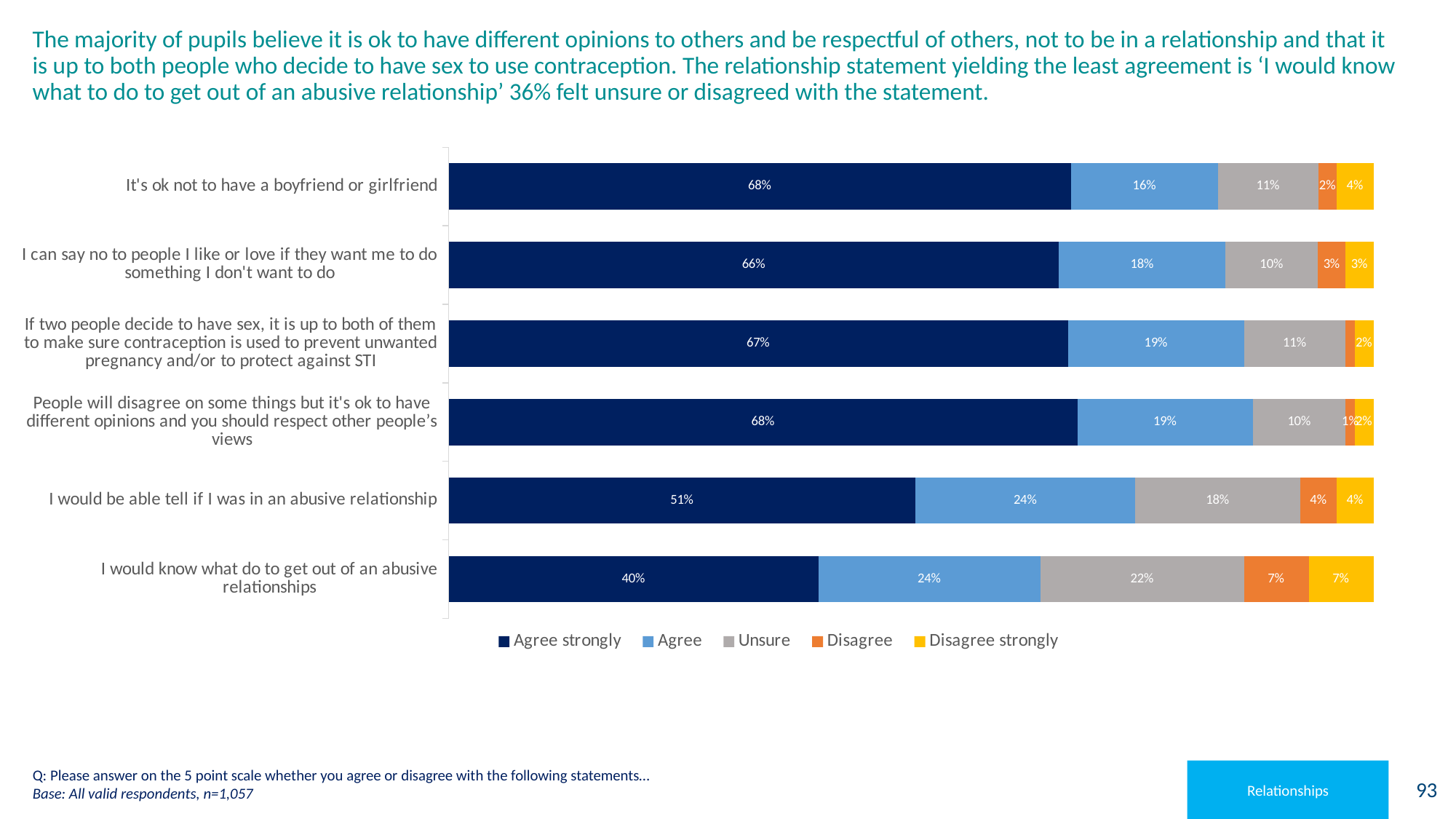
What is the difference between the Agree strongly values for 'It's ok not to have a boyfriend or girlfriend' and 'I would know what do to get out of an abusive relationships'? 28 percentage points Which legend entry is shown in yellow? Disagree strongly How many statements are shown in the chart? 6 Which statement has the highest Unsure value? I would know what do to get out of an abusive relationships How many series does the legend list? 5 Which has a larger Unsure value: 'I would be able tell if I was in an abusive relationship' or 'It's ok not to have a boyfriend or girlfriend'? I would be able tell if I was in an abusive relationship What is the Disagree strongly value for 'I can say no to people I like or love if they want me to do something I don't want to do'? 3% What kind of chart is shown on the slide? Stacked bar chart What percentage of pupils agree strongly that it's ok not to have a boyfriend or girlfriend? 68% What is the Unsure value for 'I would know what do to get out of an abusive relationships'? 22% Which statement has the lowest Agree strongly value? I would know what do to get out of an abusive relationships What percentage of pupils agree (not strongly) with 'I would be able tell if I was in an abusive relationship'? 24%